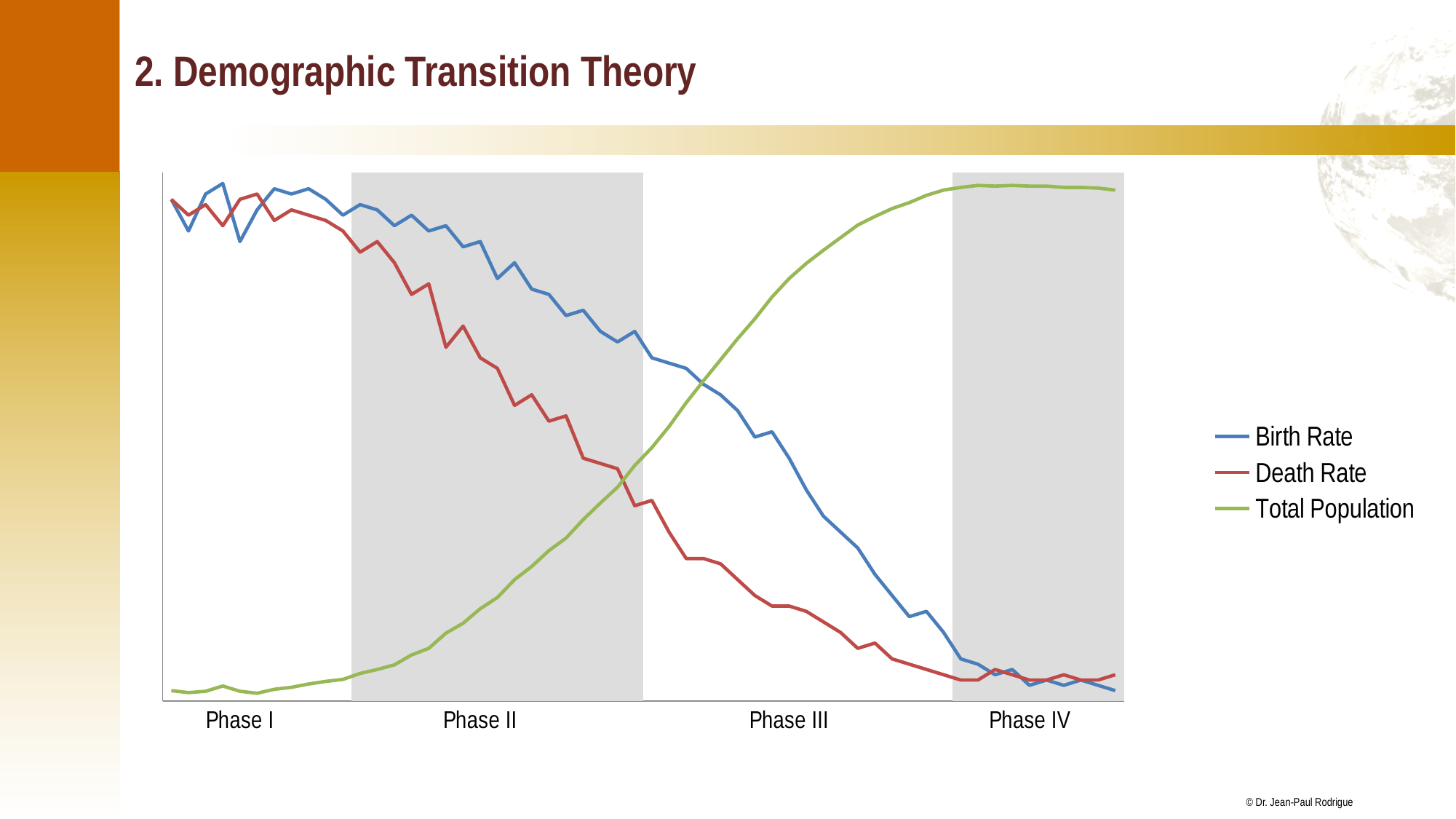
In which phase is the Total Population line at its lowest level? Phase I In which phase does the Total Population line reach its highest level? Phase IV What colour is the Total Population line? green Does the Birth Rate line rise or fall from Phase I to Phase IV? fall How many series does the legend list? 3 Which series rises along the x axis from Phase I to Phase IV? Total Population Does the Death Rate line rise or fall from Phase I to Phase IV? fall In Phase II, which is higher, the Birth Rate or the Death Rate? Birth Rate In Phase III, which is higher, the Birth Rate or the Death Rate? Birth Rate How many phases are labelled along the x axis? 4 What kind of chart is shown on the slide? line chart What is the label of the last phase on the x axis? Phase IV